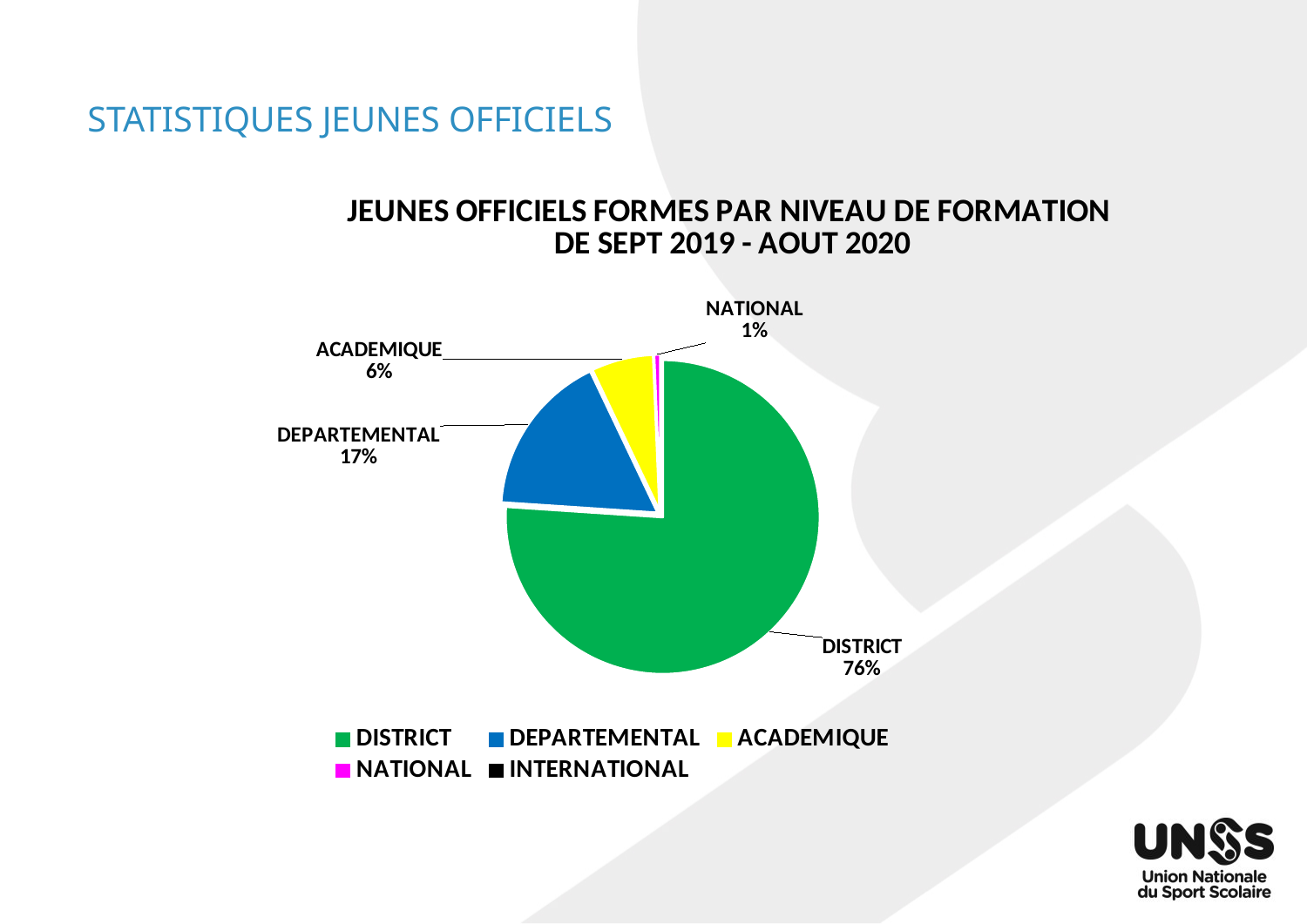
What share of the pie does DISTRICT represent? 76% What kind of chart is shown on the slide? Pie chart Which is larger, the share for DEPARTEMENTAL or the share for ACADEMIQUE? DEPARTEMENTAL What is the difference in percentage points between DISTRICT and DEPARTEMENTAL? 59 How many entries does the legend list? 5 What percentage is shown for ACADEMIQUE? 6% What percentage is shown for NATIONAL? 1% Among the labelled slices, which category has the smallest share? NATIONAL Which category has the largest share of the pie? DISTRICT What is the title of the chart? JEUNES OFFICIELS FORMES PAR NIVEAU DE FORMATION DE SEPT 2019 - AOUT 2020 What colour is used for the DISTRICT slice? Green What percentage is shown for DEPARTEMENTAL? 17%